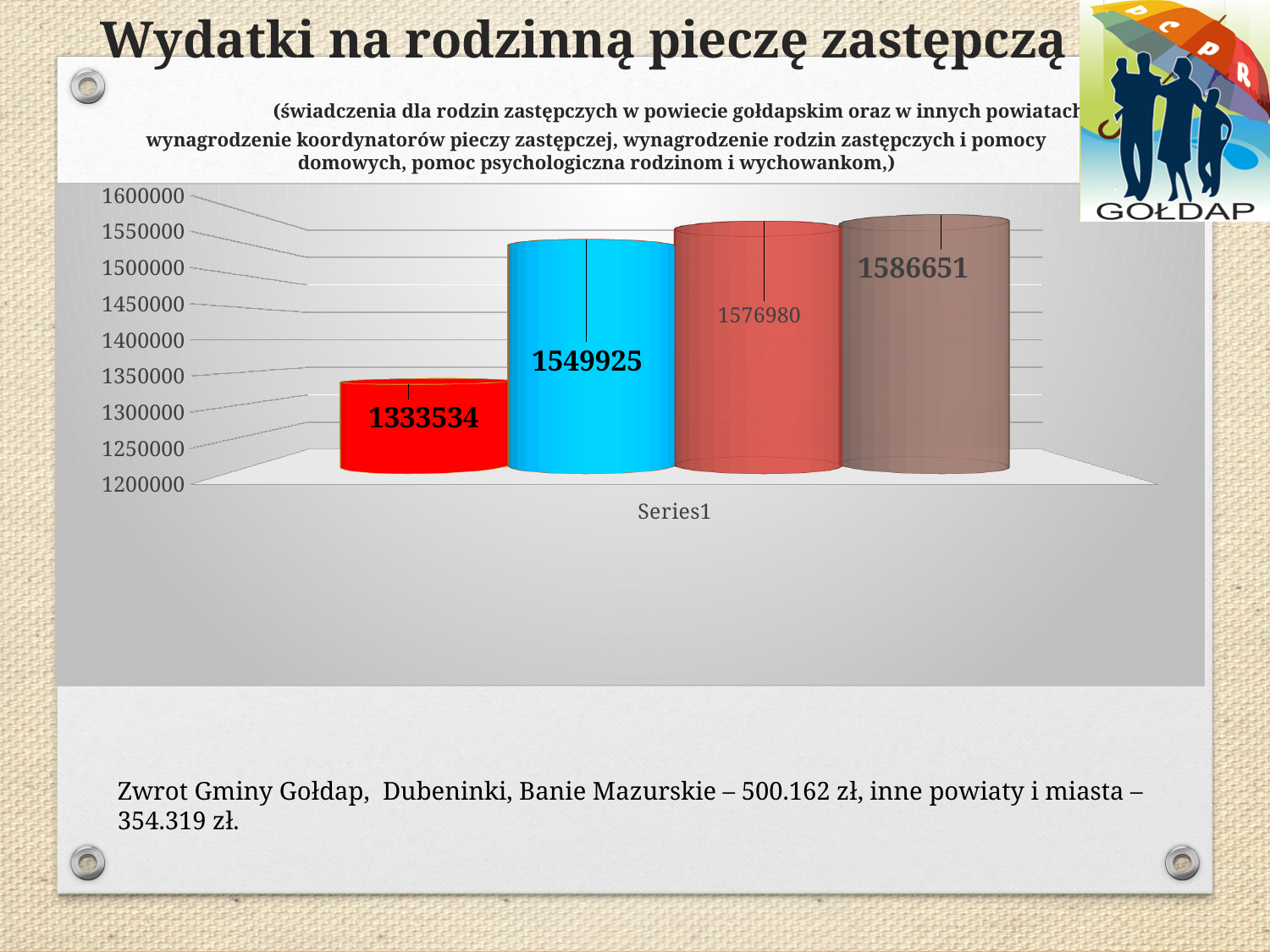
What value is shown on the brown (rightmost) bar? 1586651 What type of chart is shown on the slide? Bar chart What value is shown on the red (first, leftmost) bar? 1333534 Which bar has the lowest value? The leftmost (red) bar, 1333534 What value is shown on the third bar from the left? 1576980 Which is larger, the value of the red bar or the value of the blue bar? The blue bar (1549925) What value is shown on the blue (second) bar? 1549925 What is the difference between the blue bar (1549925) and the red bar (1333534)? 216391 Do the values rise or fall from left to right across the bars? Rise Which bar has the highest value? The rightmost (brown) bar, 1586651 What is the difference between the highest value (1586651) and the lowest value (1333534)? 253117 How many bars are plotted in the chart? 4